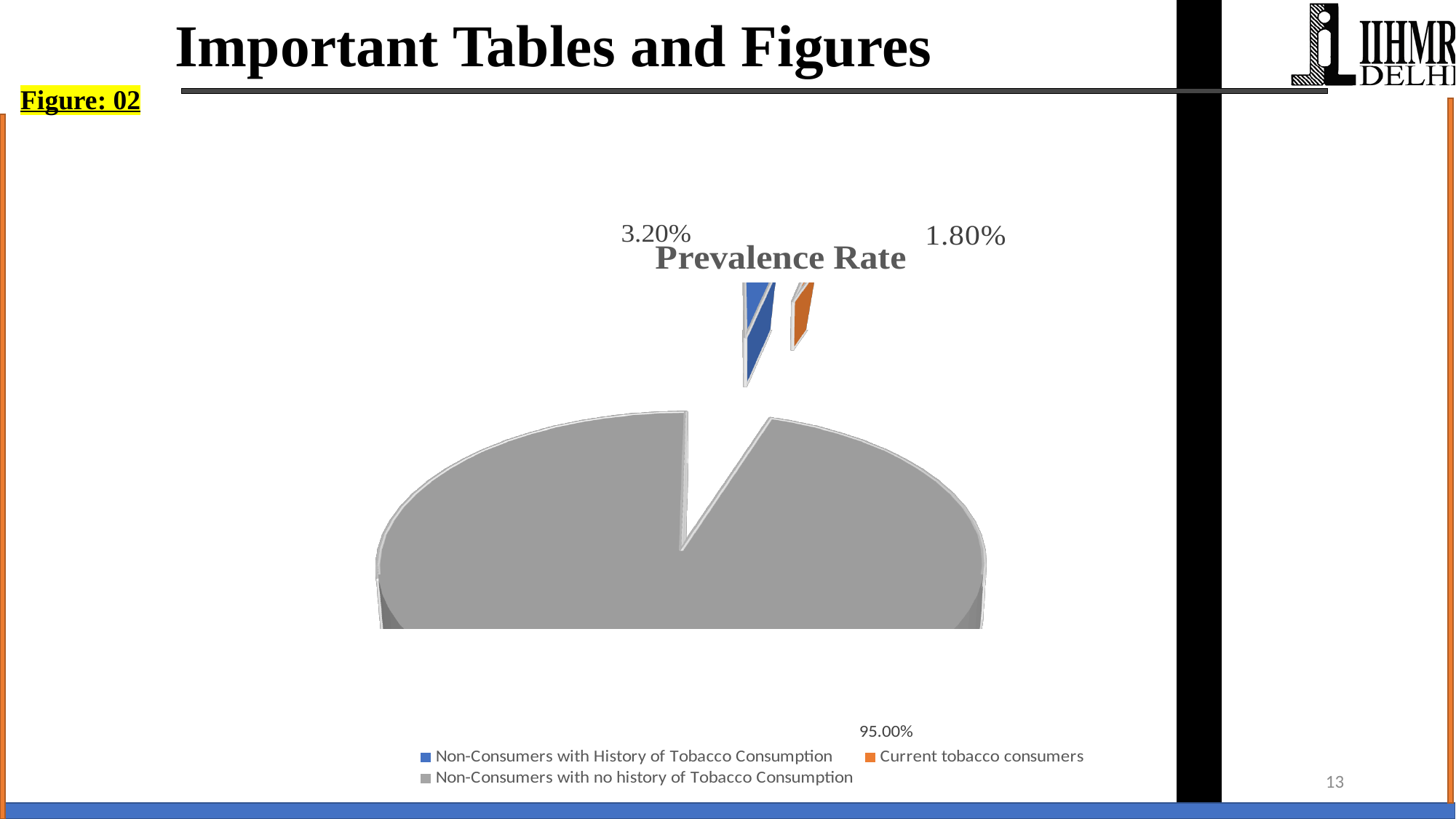
What kind of chart is shown on the slide? pie chart What is the title of the chart? Prevalence Rate What colour is the slice for Current tobacco consumers? orange What is the value for Current tobacco consumers? 1.80% Which category has the largest slice of the pie? Non-Consumers with no history of Tobacco Consumption Which category has the smallest slice of the pie? Current tobacco consumers How many slices does the pie chart have? 3 What is the difference between the values for Non-Consumers with History of Tobacco Consumption and Current tobacco consumers? 1.40% How many entries does the legend list? 3 Which is larger: the value for Non-Consumers with History of Tobacco Consumption or the value for Current tobacco consumers? Non-Consumers with History of Tobacco Consumption What is the value for Non-Consumers with History of Tobacco Consumption? 3.20% What is the value for Non-Consumers with no history of Tobacco Consumption? 95.00%